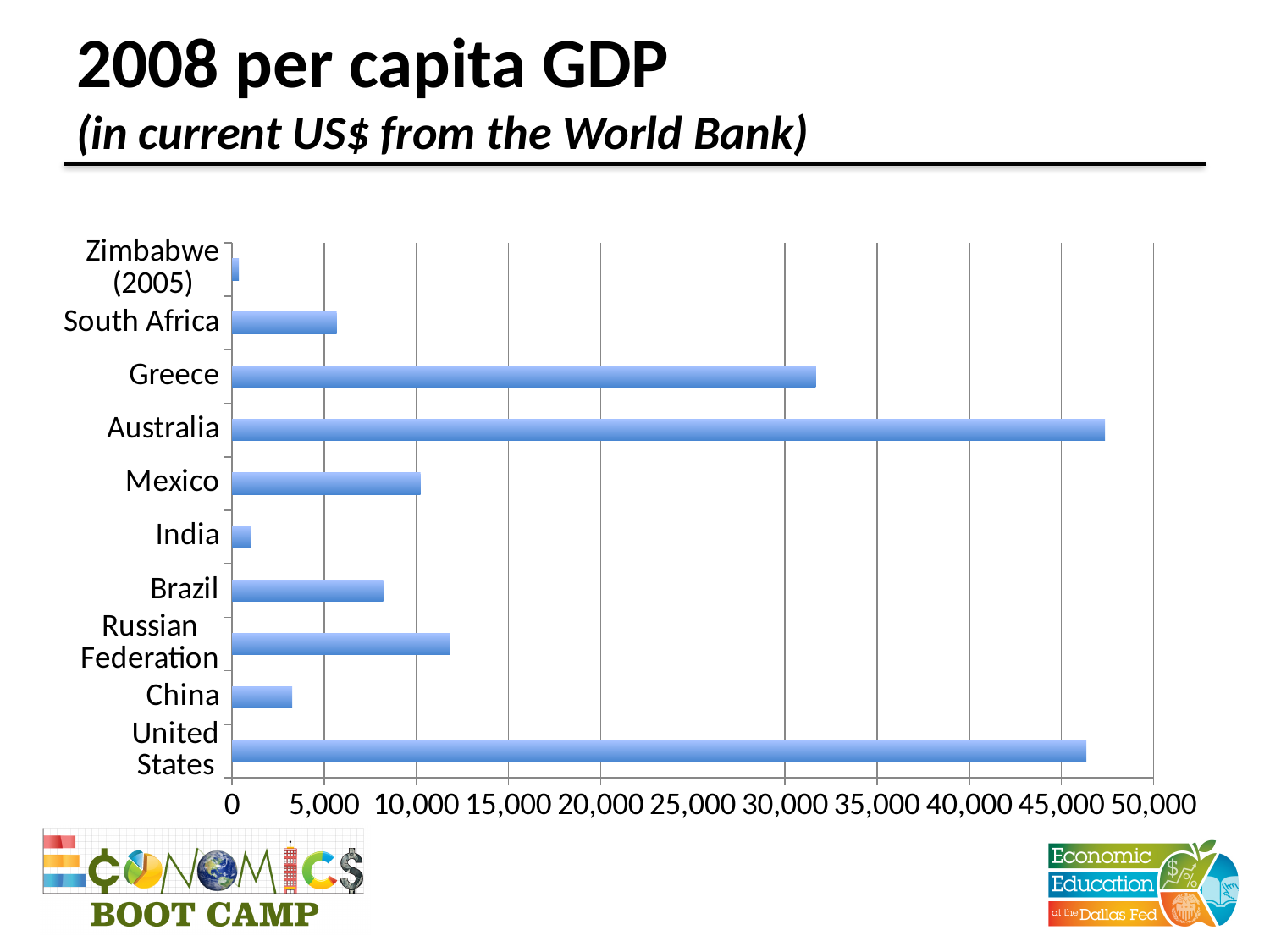
Is the value for Greece greater or less than 30,000? greater How many countries are plotted in the chart? 10 Which has the larger per capita GDP, Greece or Mexico? Greece Which has the larger per capita GDP, Brazil or the Russian Federation? Russian Federation Is the value for Mexico greater or less than 15,000? less Which has the larger per capita GDP, China or India? China What kind of chart is shown on the slide? bar chart Is the value for China greater or less than 5,000? less Which country has the lowest 2008 per capita GDP in the chart? Zimbabwe (2005) What is the title of the chart on the slide? 2008 per capita GDP (in current US$ from the World Bank)